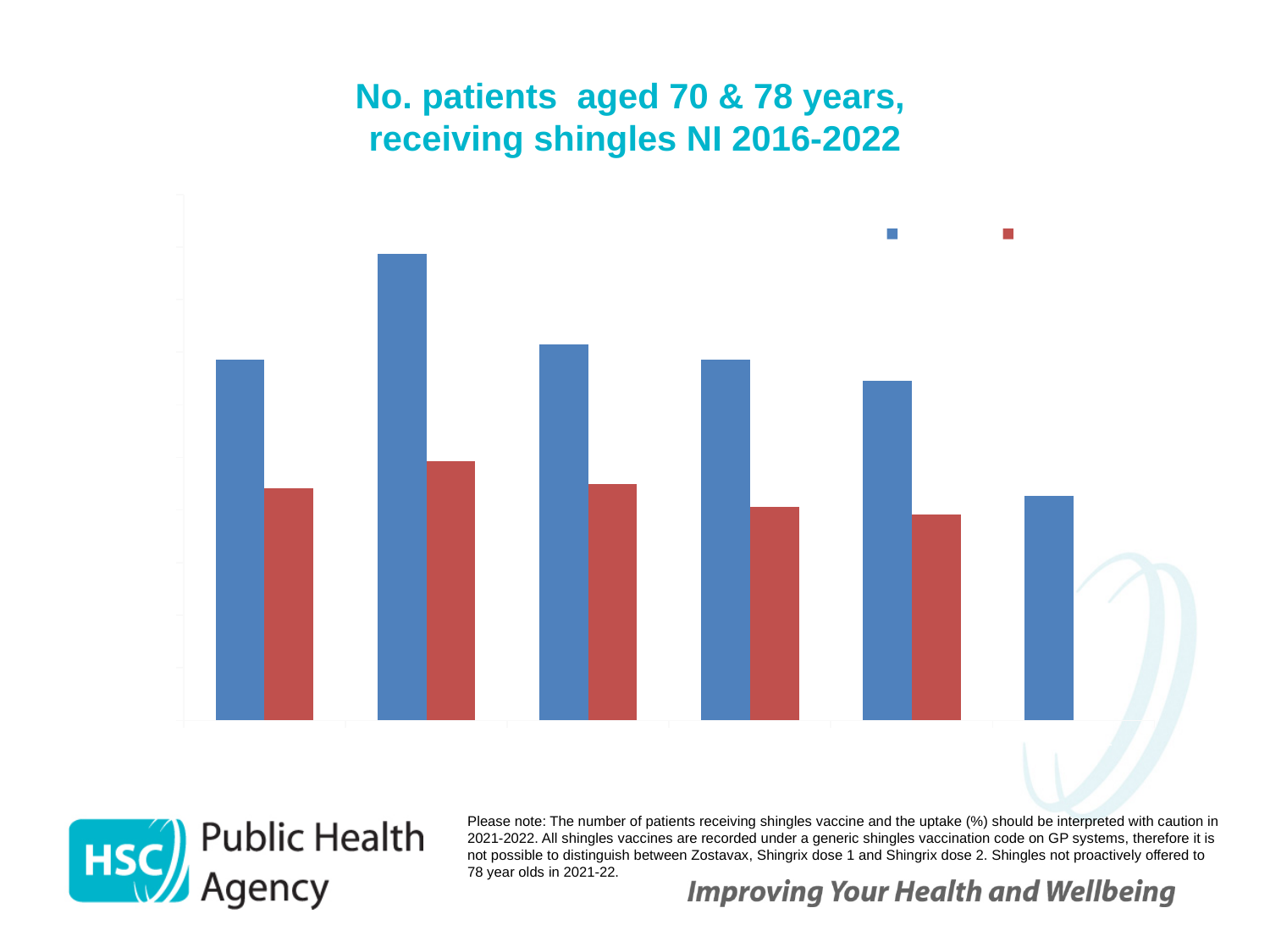
How many groups of bars have no red bar? 1 How many series does the legend show? 2 How many groups of bars are plotted along the x axis? 6 From the second group to the sixth group, do the blue bars rise or fall? Fall Which group of bars, counting from the left, has the shortest blue bar? The sixth group Which group of bars, counting from the left, has the tallest red bar? The second group What is the title of the chart? No. patients aged 70 & 78 years, receiving shingles NI 2016-2022 In the fifth group of bars, which is larger, the blue bar or the red bar? The blue bar What kind of chart is shown on the slide? Bar chart What two colours are used for the bars in the chart? Blue and red In the first group of bars, which is larger, the blue bar or the red bar? The blue bar Which group of bars, counting from the left, has the tallest blue bar? The second group